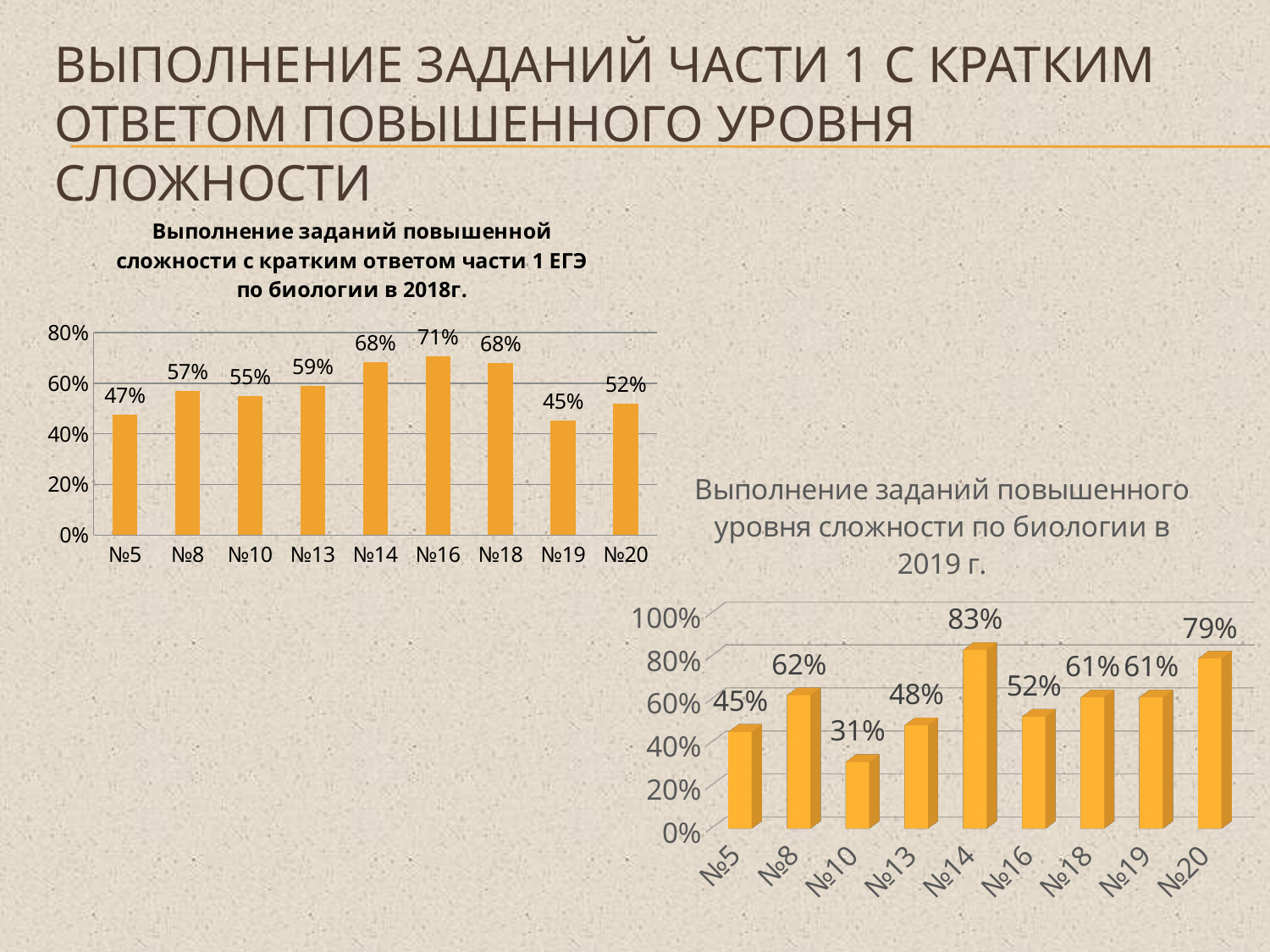
What is the title of the chart on the right? Выполнение заданий повышенного уровня сложности по биологии в 2019 г. In the 2018 chart, what is the value for №16? 71% In the 2018 chart, which task has the lowest value? №19 In the 2019 chart, which task has the highest value? №14 In the 2019 chart, what is the value for №10? 31% In the 2019 chart, is the value for №20 greater or less than 60%? greater What kind of chart is the 2019 chart? Bar chart In the 2019 chart, what is the difference between the values for №14 and №10? 52% In the 2018 chart, what is the value for №13? 59% In the 2018 chart, how many tasks are shown on the x axis? 9 In the 2019 chart, which is larger: the value for №8 or the value for №16? №8 In the 2018 chart, what is the difference between the values for №16 and №5? 24%